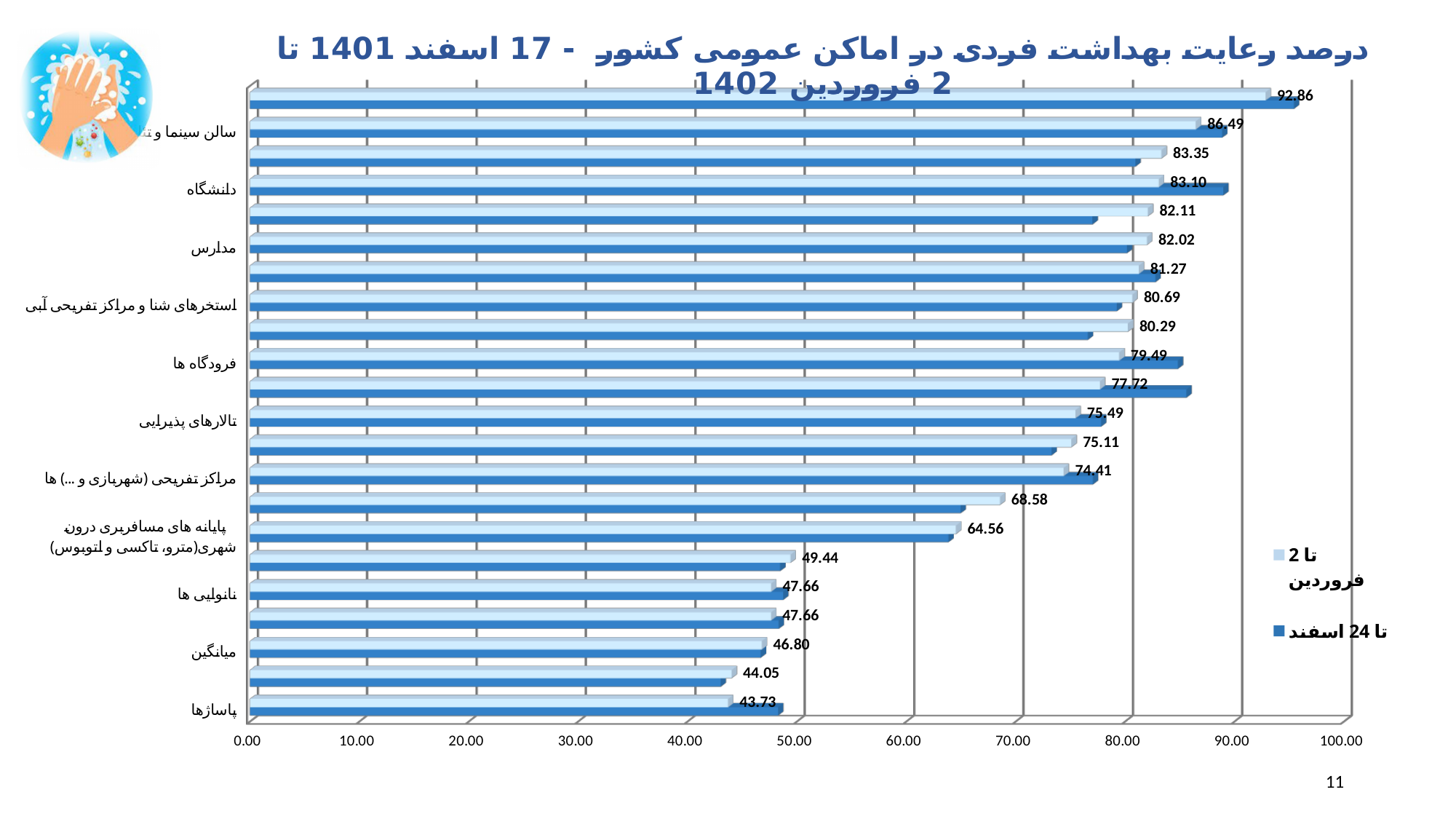
What is the value for دانشگاه in the تا 2 فروردین series? 83.10 Is the تا 24 اسفند value for دانشگاه greater or less than 80.00? greater What is the difference between دانشگاه and مدارس in the تا 2 فروردین series? 1.08 Which labeled category has the lowest value in the تا 2 فروردین series? پاساژها How many series does the legend list? 2 What is the value for میانگین in the تا 2 فروردین series? 46.80 Which is larger in the تا 2 فروردین series: فرودگاه ها or تالارهای پذیرایی? فرودگاه ها Is the تا 24 اسفند value for پاساژها greater or less than 50.00? less What is the value for پاساژها in the تا 2 فروردین series? 43.73 What is the value for فرودگاه ها in the تا 2 فروردین series? 79.49 What kind of chart is shown on the slide? Bar chart What is the highest data label shown for the تا 2 فروردین series? 92.86